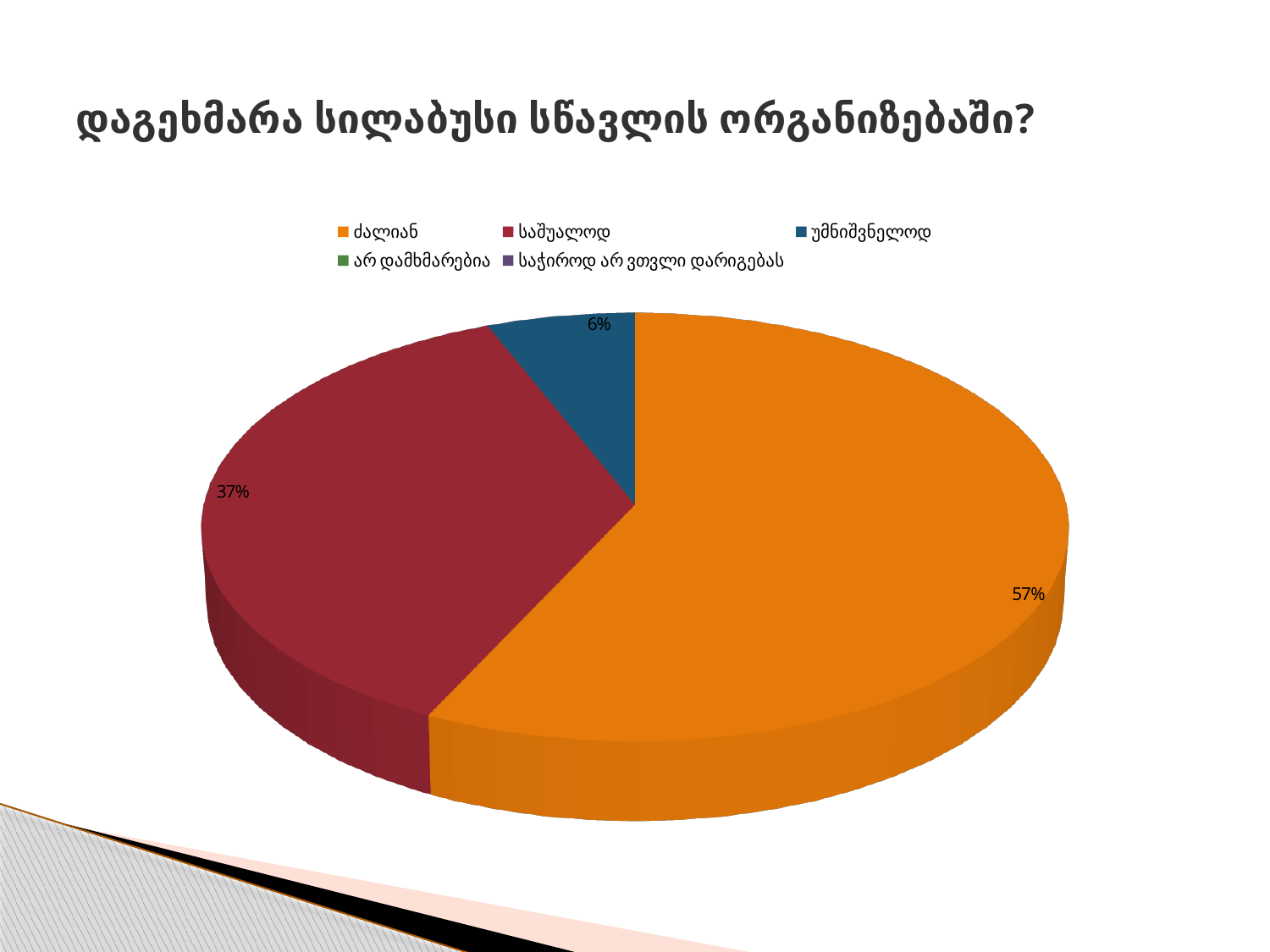
Which slice is larger, საშუალოდ or უმნიშვნელოდ? საშუალოდ What colour is the ძალიან slice? orange What is the title of the chart slide? დაგეხმარა სილაბუსი სწავლის ორგანიზებაში? Which of the slices with a printed label is the smallest? უმნიშვნელოდ What type of chart is shown on the slide? pie chart How many slices with printed percentage labels are visible in the pie? 3 Which category has the largest slice of the pie? ძალიან What percentage of the pie is the ძალიან slice? 57% What percentage of the pie is the საშუალოდ slice? 37% What percentage of the pie is the უმნიშვნელოდ slice? 6% What is the difference in percentage points between the ძალიან slice and the საშუალოდ slice? 20 How many categories does the legend list? 5